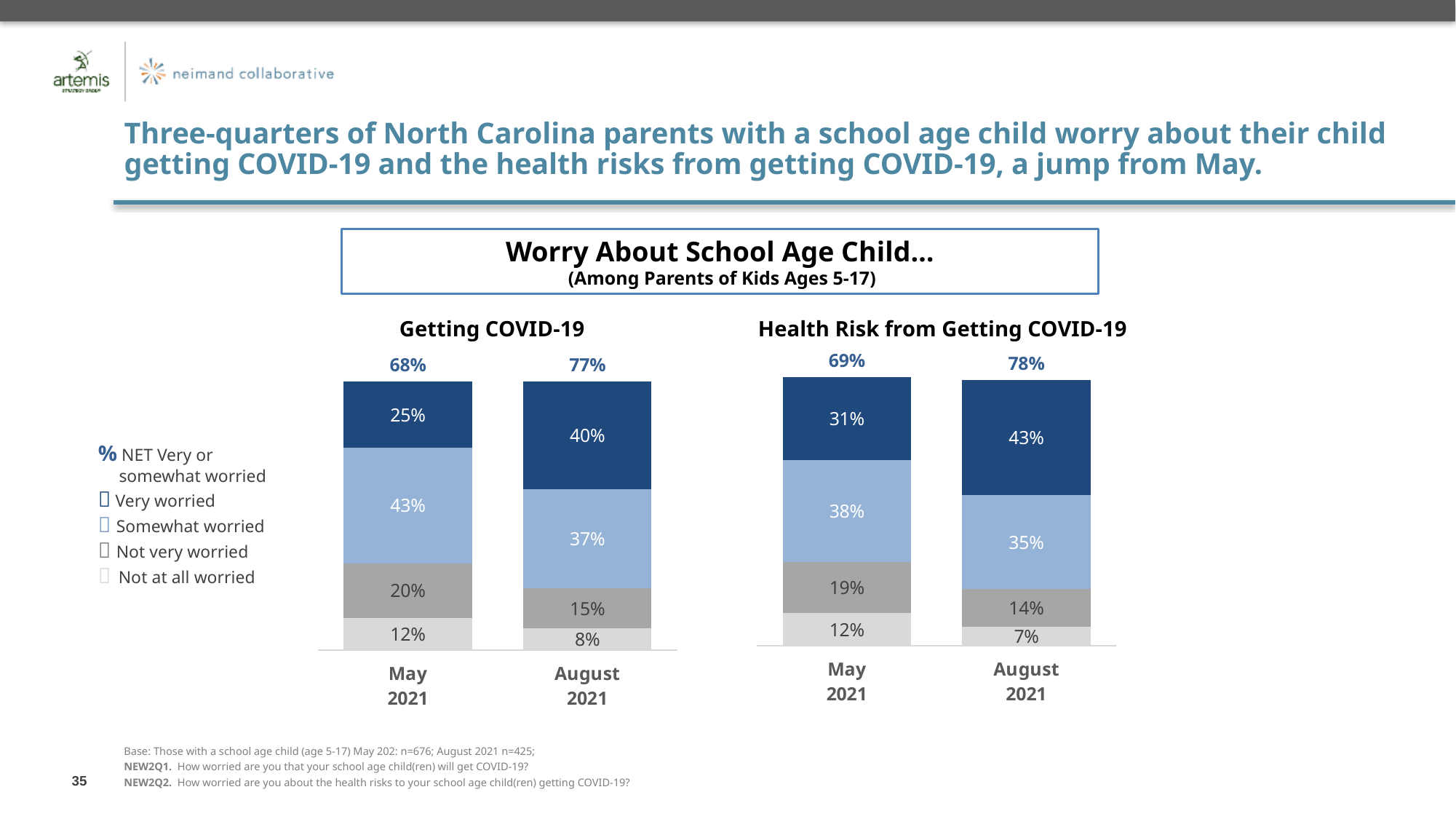
In the "Getting COVID-19" chart, what percentage of parents were somewhat worried in May 2021? 43% What type of chart is used to show worry about school age children? Stacked bar chart In the "Getting COVID-19" chart, which is larger: the not very worried share in May 2021 or in August 2021? May 2021 In the "Getting COVID-19" chart, by how many percentage points did the very worried share change from May 2021 to August 2021? 15 percentage points How many worry levels does the legend list for the stacked bars? 4 In the "Health Risk from Getting COVID-19" chart, what is the NET very or somewhat worried percentage for May 2021? 69% In the "Health Risk from Getting COVID-19" chart, what percentage of parents were not at all worried in August 2021? 7% In the "Getting COVID-19" chart, what percentage of parents were very worried in August 2021? 40% How many time periods are shown on the x axis of each chart? 2 In the "Getting COVID-19" chart, which segment of the August 2021 bar is the smallest? Not at all worried (8%) In the "Health Risk from Getting COVID-19" chart, what is the difference between the NET worried percentages for August 2021 and May 2021? 9 percentage points In the "Health Risk from Getting COVID-19" chart, which time period has the higher very worried percentage? August 2021